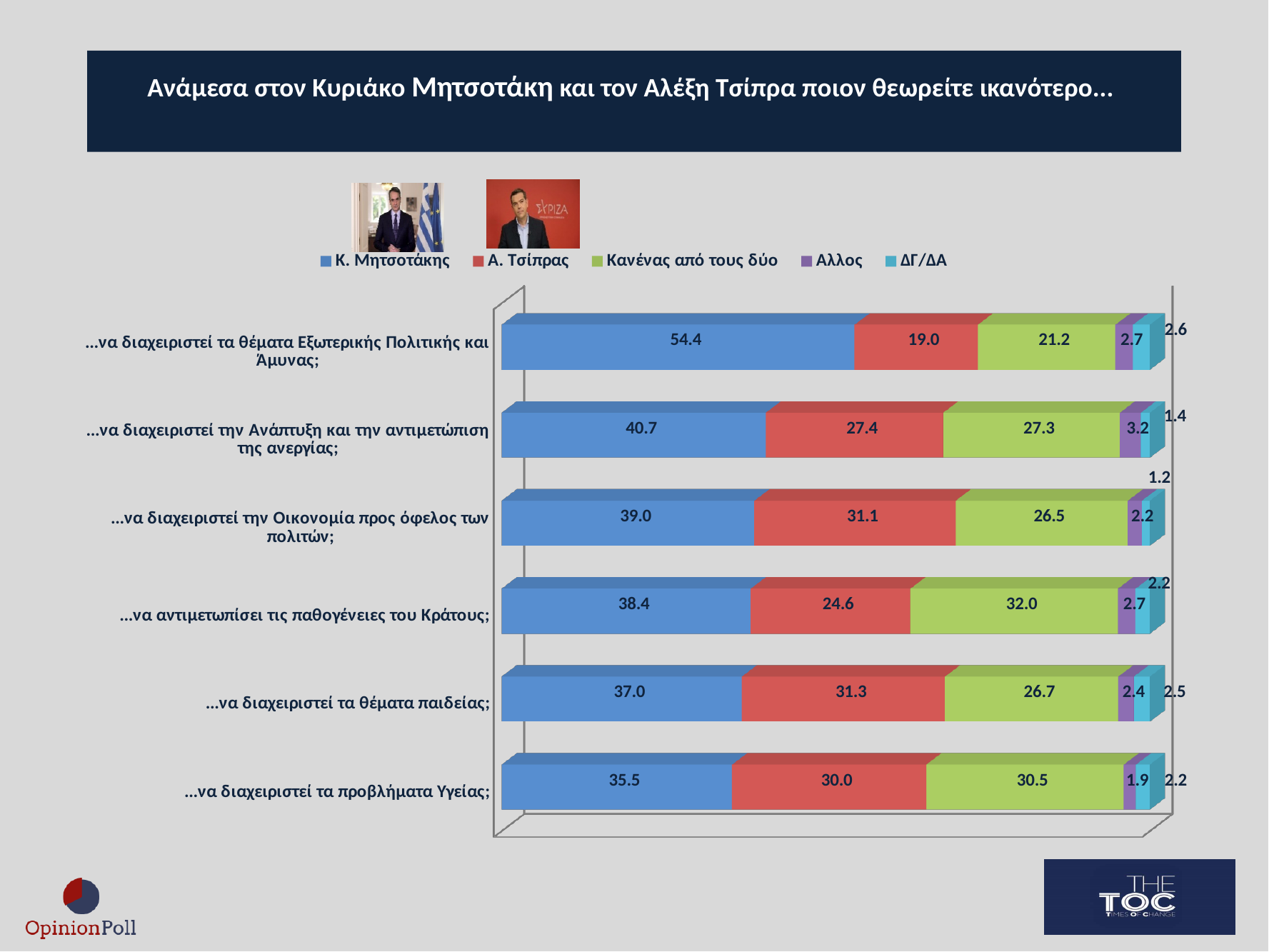
What is the value for Άλλος in the category "...να διαχειριστεί την Ανάπτυξη και την αντιμετώπιση της ανεργίας;"? 3.2 How many series does the legend list? 5 What kind of chart is shown on the slide? Stacked bar chart In which category does Α. Τσίπρας have the lowest value? ...να διαχειριστεί τα θέματα Εξωτερικής Πολιτικής και Άμυνας; How many categories (questions) are shown on the chart? 6 In which category does Κ. Μητσοτάκης have the highest value? ...να διαχειριστεί τα θέματα Εξωτερικής Πολιτικής και Άμυνας; Which colour represents ΔΓ/ΔΑ in the legend? Light blue What is the value for Κανένας από τους δύο in the category "...να αντιμετωπίσει τις παθογένειες του Κράτους;"? 32.0 In the category "...να διαχειριστεί τα θέματα παιδείας;", which is larger: the value for Α. Τσίπρας or for Κανένας από τους δύο? Α. Τσίπρας What is the value for Κ. Μητσοτάκης in the category "...να διαχειριστεί τα θέματα Εξωτερικής Πολιτικής και Άμυνας;"? 54.4 What is the difference between the Κ. Μητσοτάκης and Α. Τσίπρας values in the category "...να διαχειριστεί τα προβλήματα Υγείας;"? 5.5 What is the value for Α. Τσίπρας in the category "...να διαχειριστεί την Οικονομία προς όφελος των πολιτών;"? 31.1